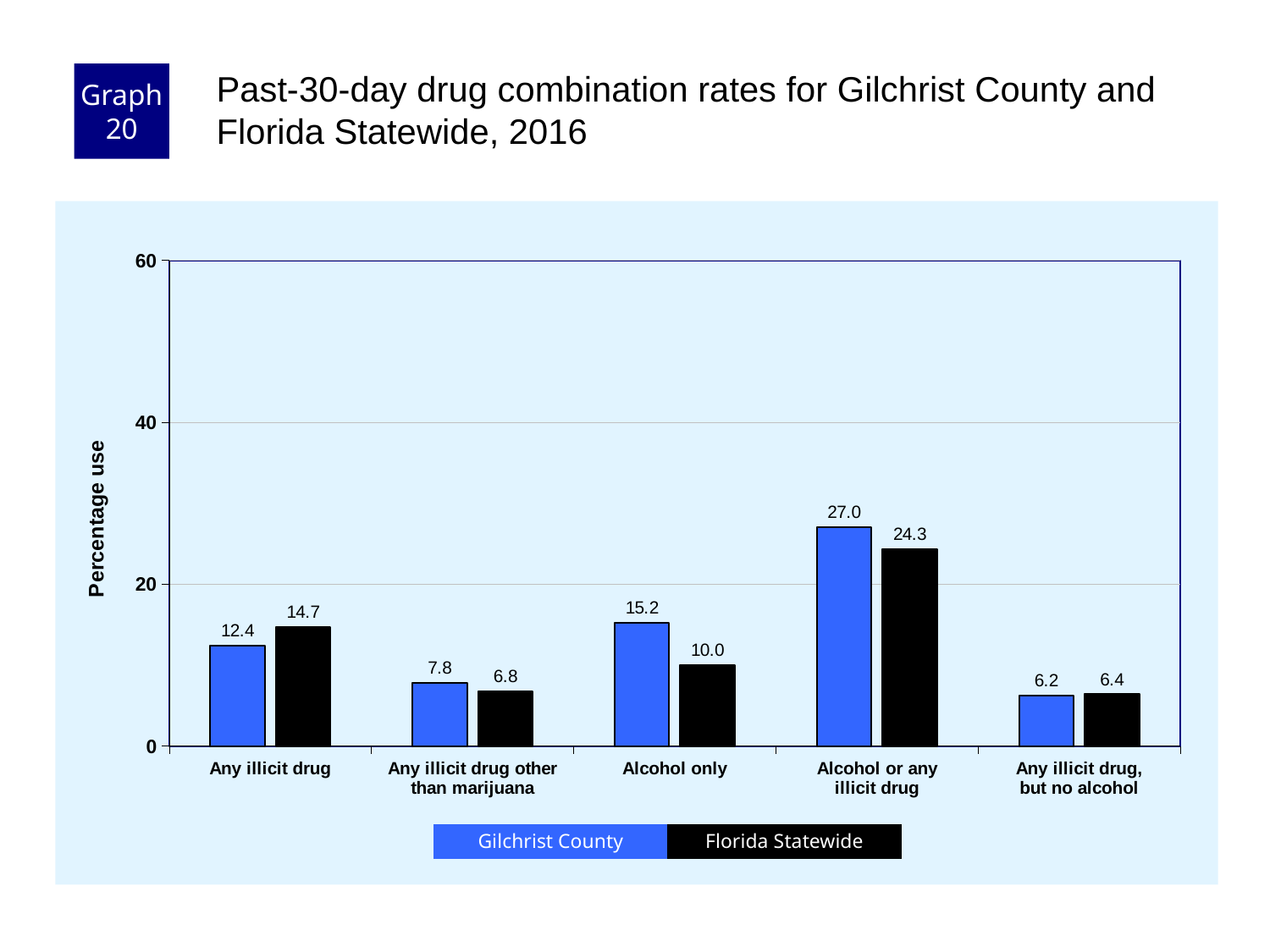
What is the Gilchrist County value for Any illicit drug, but no alcohol? 6.2 For Any illicit drug other than marijuana, which is larger: Gilchrist County or Florida Statewide? Gilchrist County How many series does the legend list? 2 What is the difference between the Gilchrist County and Florida Statewide values for Alcohol only? 5.2 What is the Gilchrist County value for Alcohol only? 15.2 Which category has the lowest Florida Statewide value? Any illicit drug, but no alcohol What kind of chart is shown on the slide? bar chart Which category has the highest Gilchrist County value? Alcohol or any illicit drug Is the Florida Statewide value for Alcohol or any illicit drug greater or less than 20? greater What is the Florida Statewide value for Any illicit drug? 14.7 How many categories are shown on the x axis? 5 What is the difference between the Gilchrist County and Florida Statewide values for Alcohol or any illicit drug? 2.7